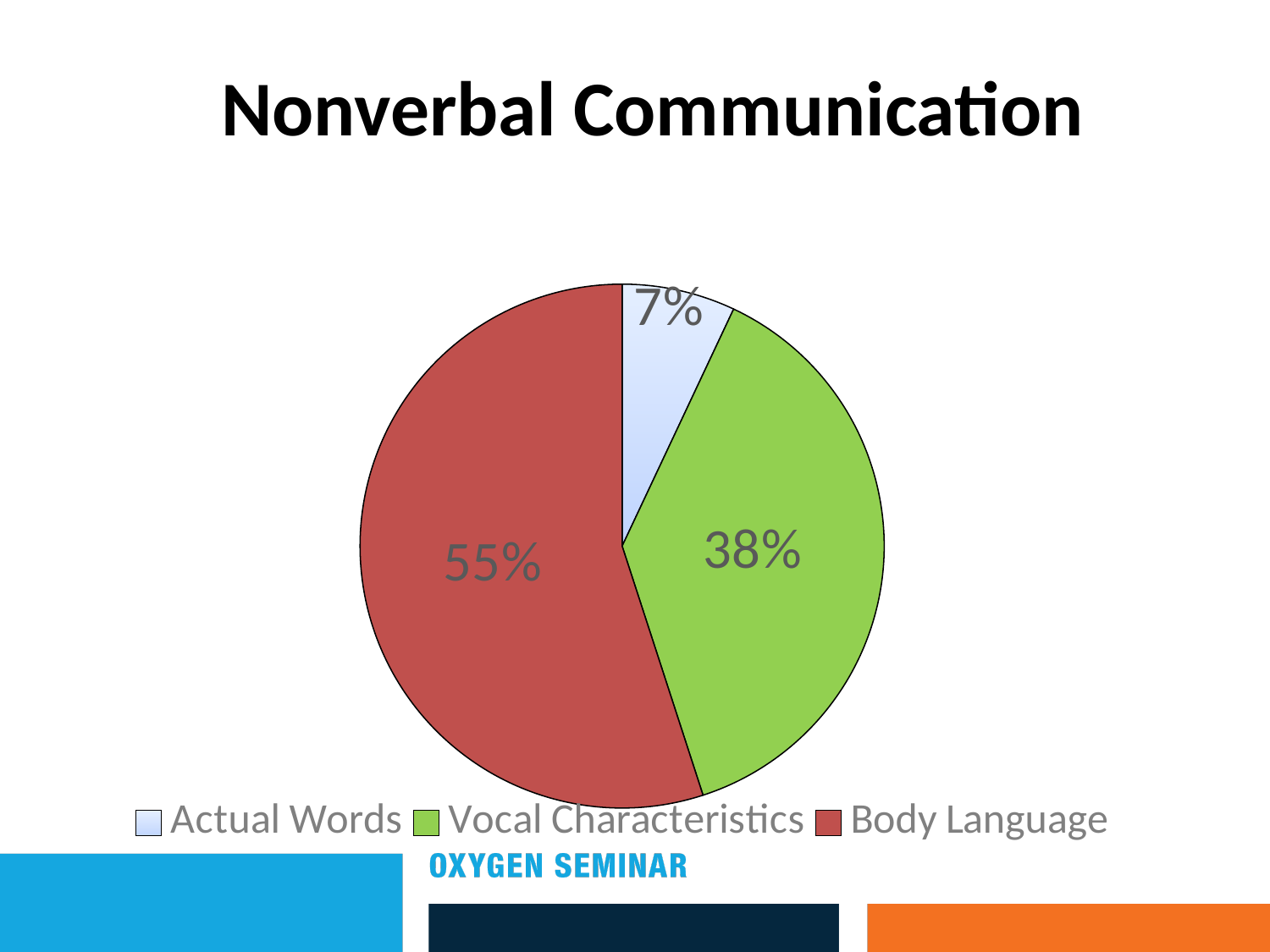
Which category has the largest slice of the pie? Body Language How many categories does the pie chart have? 3 What share of the pie does Body Language take? 55% Which is larger, the share for Vocal Characteristics or the share for Actual Words? Vocal Characteristics What share of the pie does Vocal Characteristics take? 38% What is the difference between the Body Language share and the Vocal Characteristics share? 17% What kind of chart is shown on the slide? pie chart What is the title of the slide containing the pie chart? Nonverbal Communication Which colour represents Vocal Characteristics in the legend? green What is the difference between the Vocal Characteristics share and the Actual Words share? 31% Which category has the smallest slice of the pie? Actual Words What share of the pie does Actual Words take? 7%